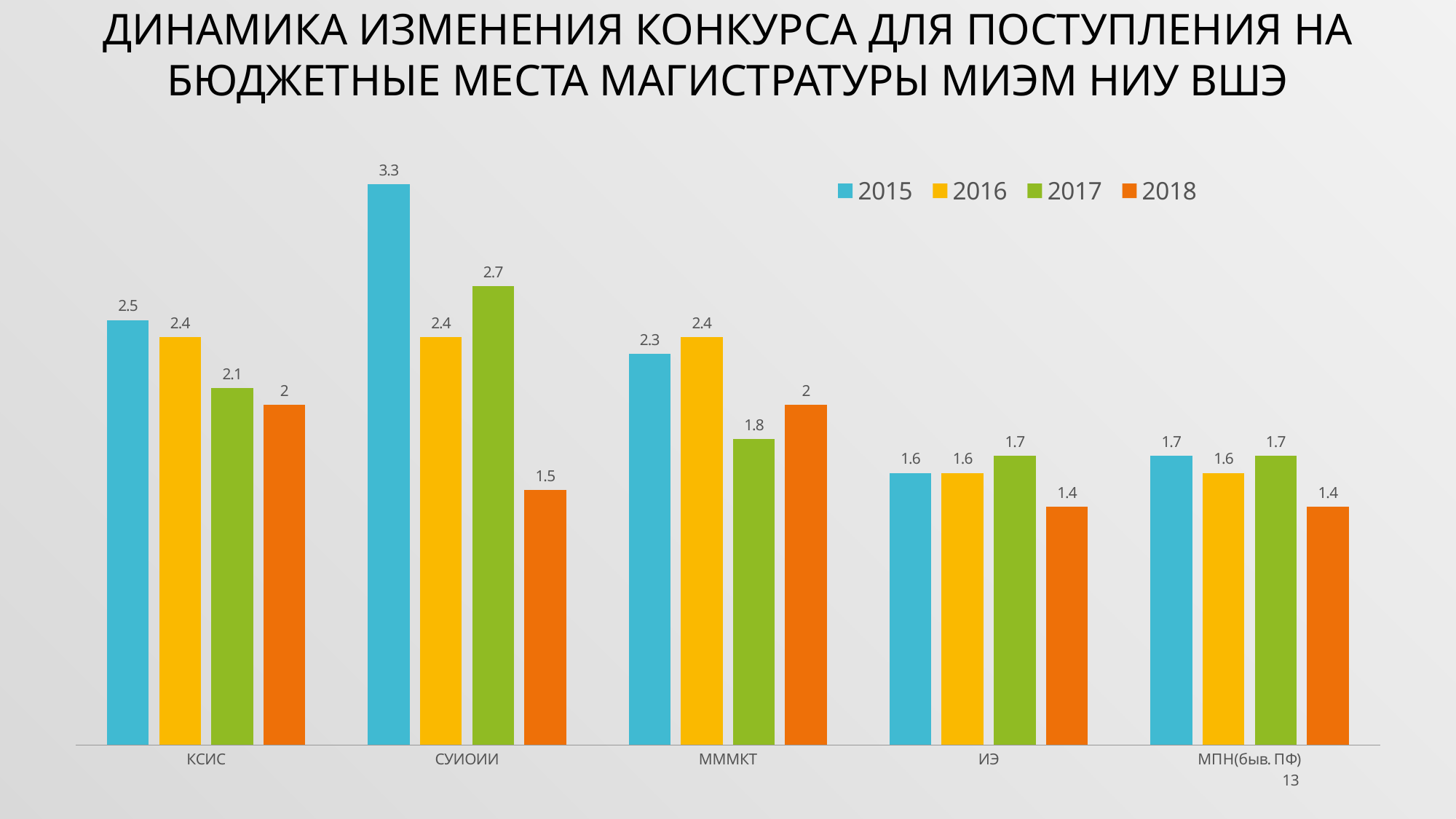
Which category has the lowest value in 2018? ИЭ and МПН(быв. ПФ) (both 1.4) Which is larger for МММКТ: the 2016 value or the 2017 value? 2016 Which colour represents the 2018 series in the legend? Orange What is the value for КСИС in 2017? 2.1 What is the difference between the 2015 and 2018 values for СУИОИИ? 1.8 Which category has the highest value in 2015? СУИОИИ How many categories are shown on the x axis? 5 What is the value for МММКТ in 2018? 2 Do the values for КСИС rise or fall from 2015 to 2018? Fall How many series does the legend list? 4 What kind of chart is shown on the slide? Bar chart What is the value for СУИОИИ in 2015? 3.3